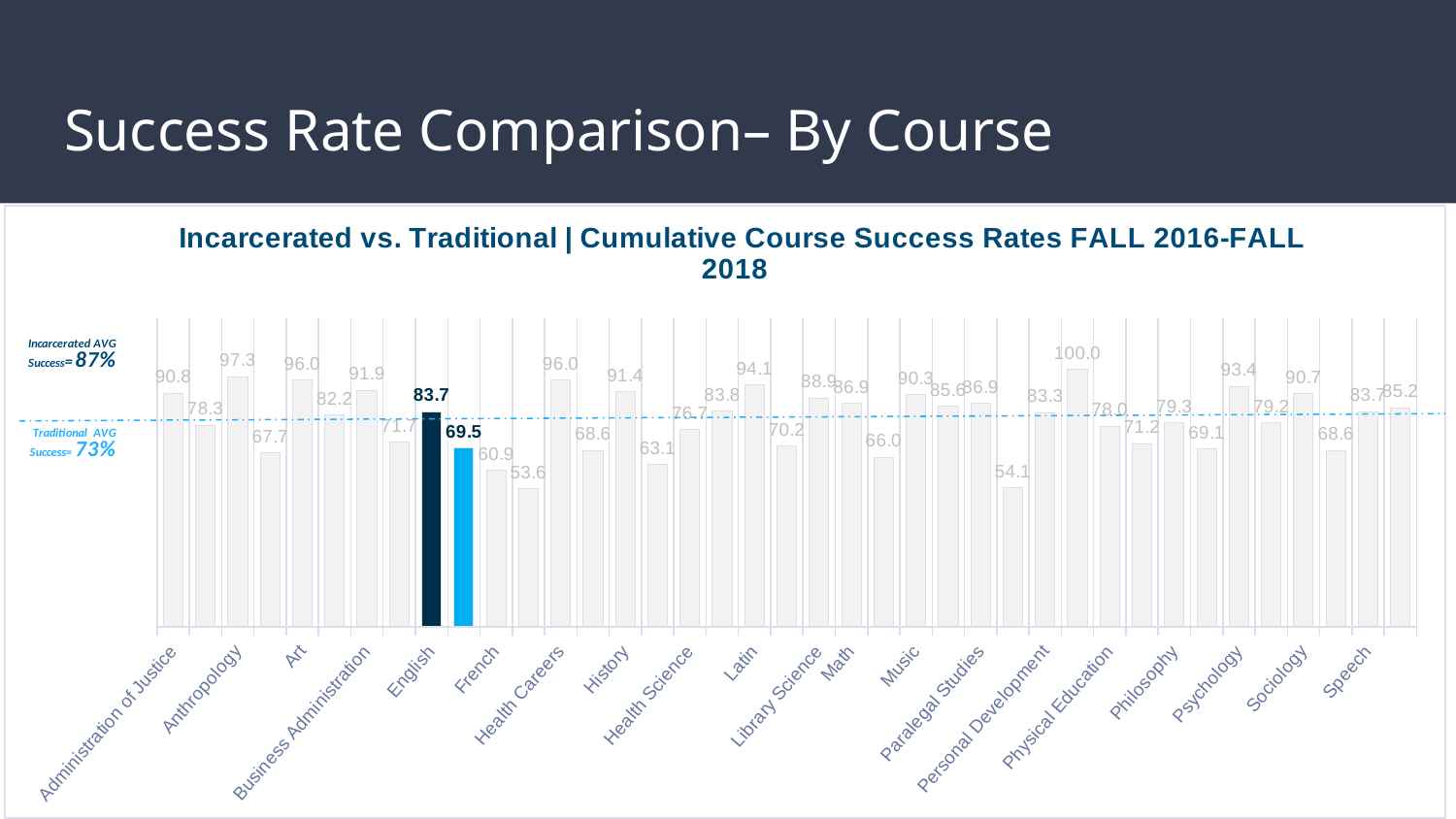
What is the Incarcerated AVG Success rate shown on the chart? 87% Which of the two English bars is larger, the dark navy one or the light blue one? The dark navy one (83.7) What is the difference between the Incarcerated AVG Success and the Traditional AVG Success? 14 percentage points What is the difference between the two English bars (83.7 and 69.5)? 14.2 How many courses are listed along the x axis of the chart? 20 What is the title of the chart? Incarcerated vs. Traditional | Cumulative Course Success Rates FALL 2016-FALL 2018 What is the lowest value labeled on any bar in the chart? 53.6 What are the two values labeled for English? 83.7 and 69.5 What is the Traditional AVG Success rate shown on the chart? 73% What kind of chart is shown on the slide? Bar chart What is the highest value labeled on any bar in the chart? 100.0 Which course's bars are highlighted in colour (dark navy and light blue) rather than grey? English